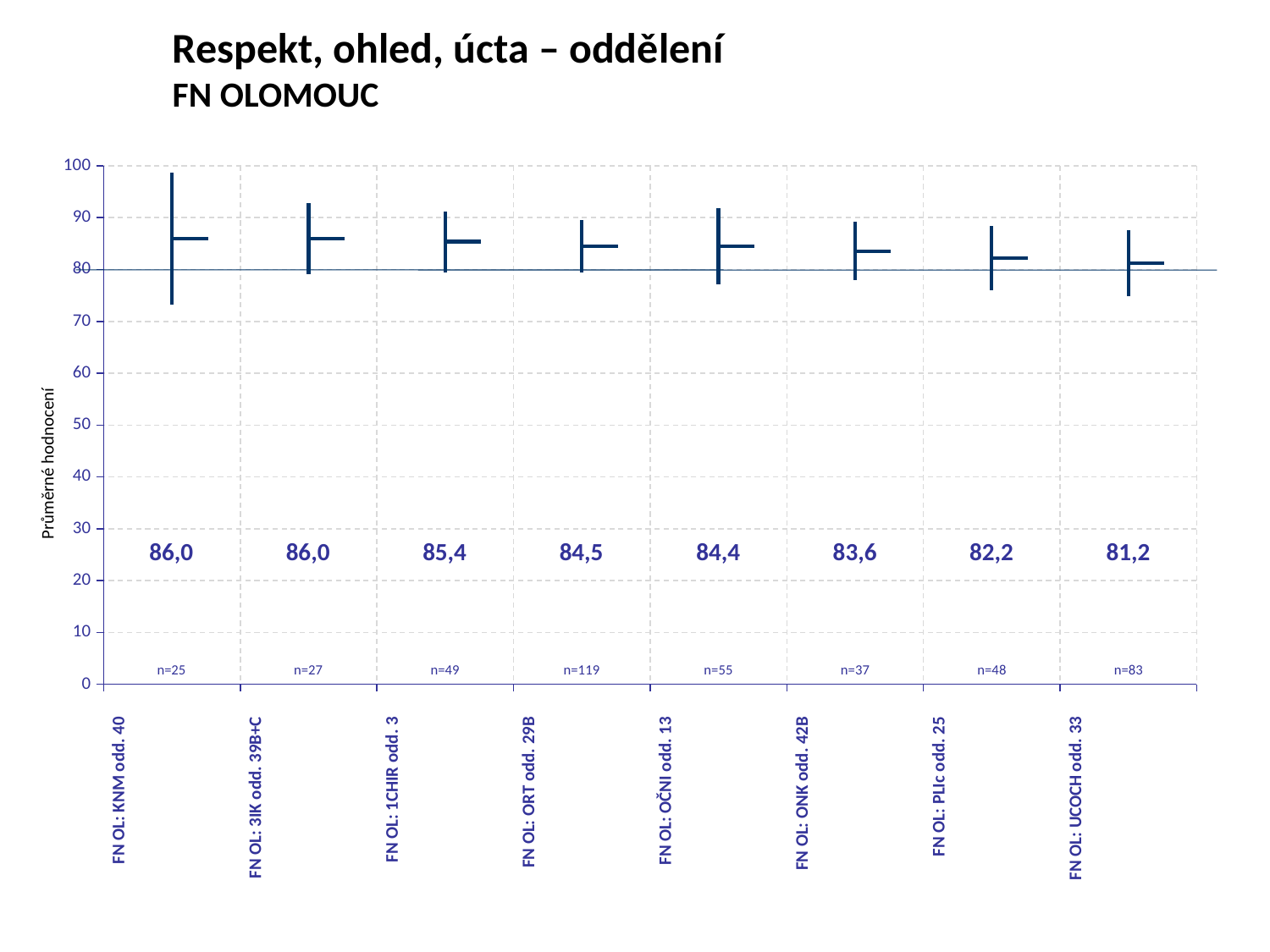
Is the average rating for FN OL: UCOCH odd. 33 greater or less than 80? greater What is the average rating (Průměrné hodnocení) for FN OL: 1CHIR odd. 3? 85,4 What is the number of respondents (n) shown for FN OL: ORT odd. 29B? n=119 What is the average rating for FN OL: ORT odd. 29B? 84,5 Which has the higher average rating, FN OL: OČNI odd. 13 or FN OL: PLIc odd. 25? FN OL: OČNI odd. 13 What is the average rating for FN OL: ONK odd. 42B? 83,6 What is the difference between the average ratings of FN OL: 1CHIR odd. 3 and FN OL: PLIc odd. 25? 3,2 What is the label of the vertical axis? Průměrné hodnocení What is the difference between the average ratings of FN OL: KNM odd. 40 and FN OL: UCOCH odd. 33? 4,8 How many departments are shown on the chart? 8 Which department has the lowest average rating? FN OL: UCOCH odd. 33 Do the average ratings rise or fall from left to right across the departments? fall